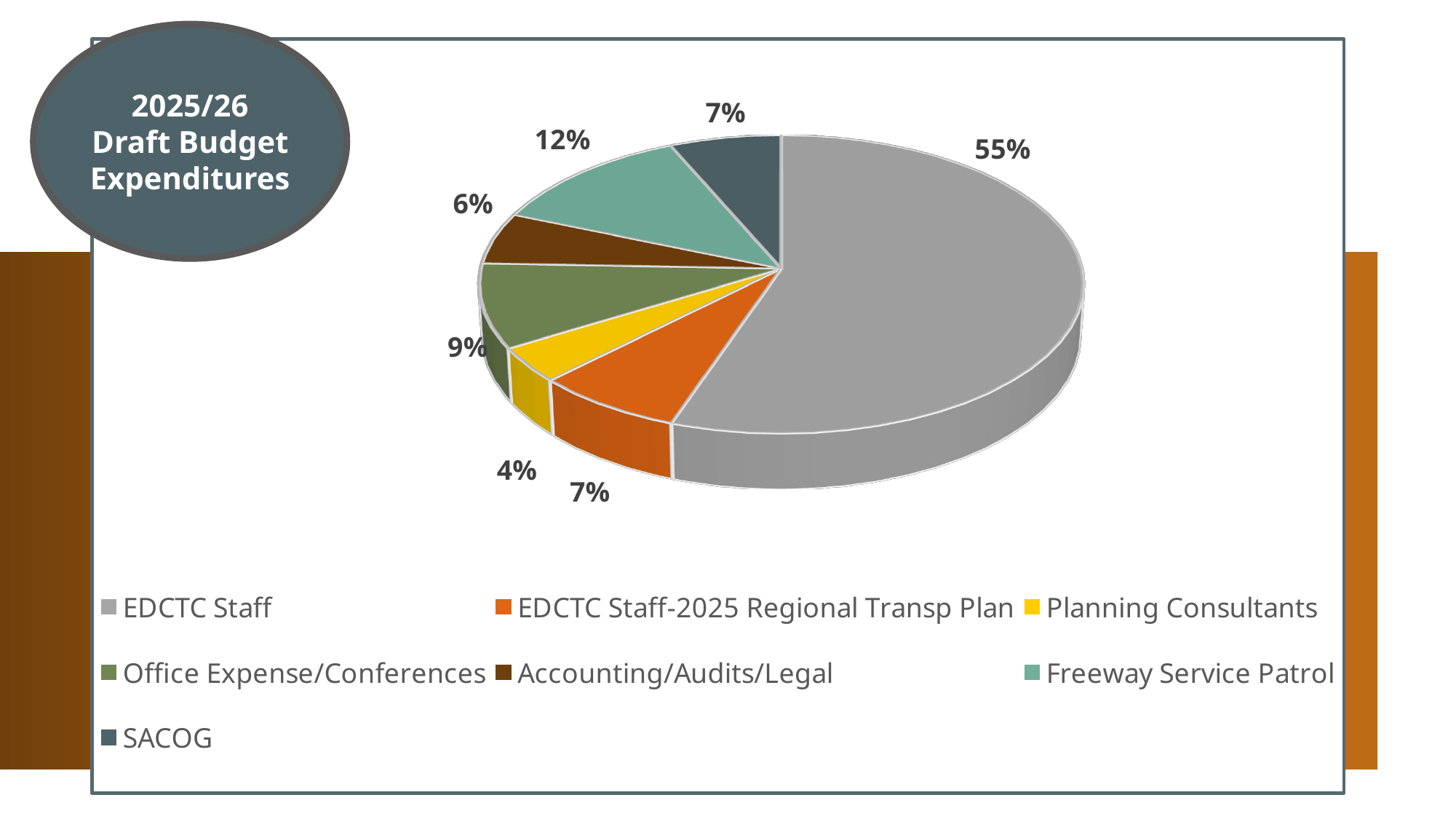
What is the difference in percentage points between Freeway Service Patrol and Office Expense/Conferences? 3 What kind of chart is shown on the slide? pie chart What percentage of expenditures is Accounting/Audits/Legal? 6% What percentage of expenditures is Office Expense/Conferences? 9% Which is larger, the share for Freeway Service Patrol or the share for SACOG? Freeway Service Patrol Which category has the smallest share of expenditures? Planning Consultants What percentage of expenditures is Planning Consultants? 4% How many categories does the pie chart show? 7 What percentage of expenditures is Freeway Service Patrol? 12% Which category has the largest share of expenditures? EDCTC Staff What is the title shown in the oval on the slide? 2025/26 Draft Budget Expenditures What share of the 2025/26 draft budget expenditures is EDCTC Staff? 55%